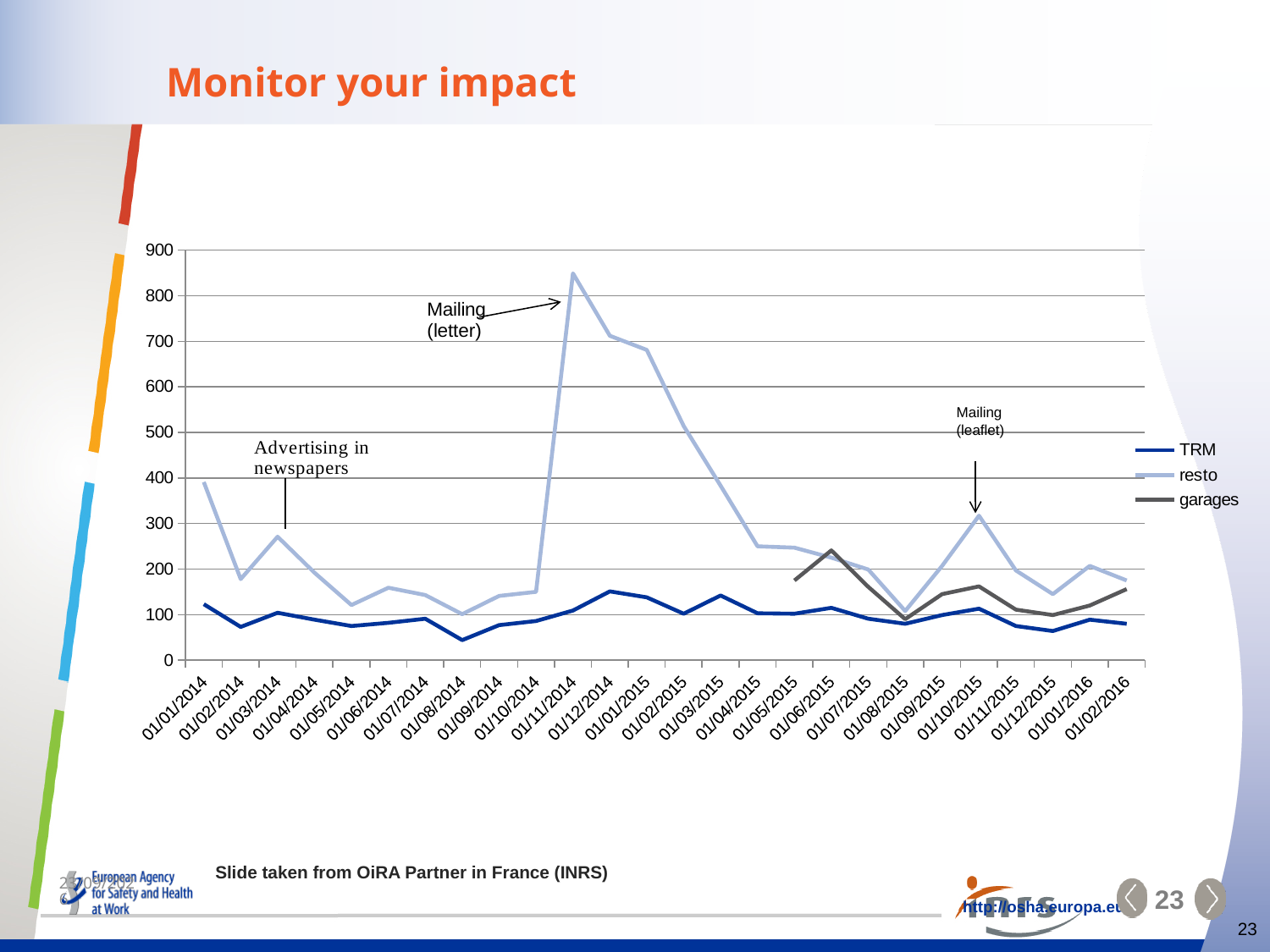
Does the resto series rise or fall between 01/11/2014 and 01/04/2015? fall On which date does the resto series reach its peak? 01/11/2014 Which series reaches the highest value on the chart? resto Is the value for TRM on 01/08/2014 greater or less than 100? less Is the value for resto on 01/11/2014 greater or less than 800? greater On which date does the TRM series reach its lowest value? 01/08/2014 Is the value for garages on 01/06/2015 greater or less than 200? greater How many dates are shown along the x axis? 26 Which annotation points to the peak of the resto series? Mailing (letter) What kind of chart is shown on the slide? line chart How many series does the legend list? 3 On 01/06/2015, which series has the larger value, garages or TRM? garages